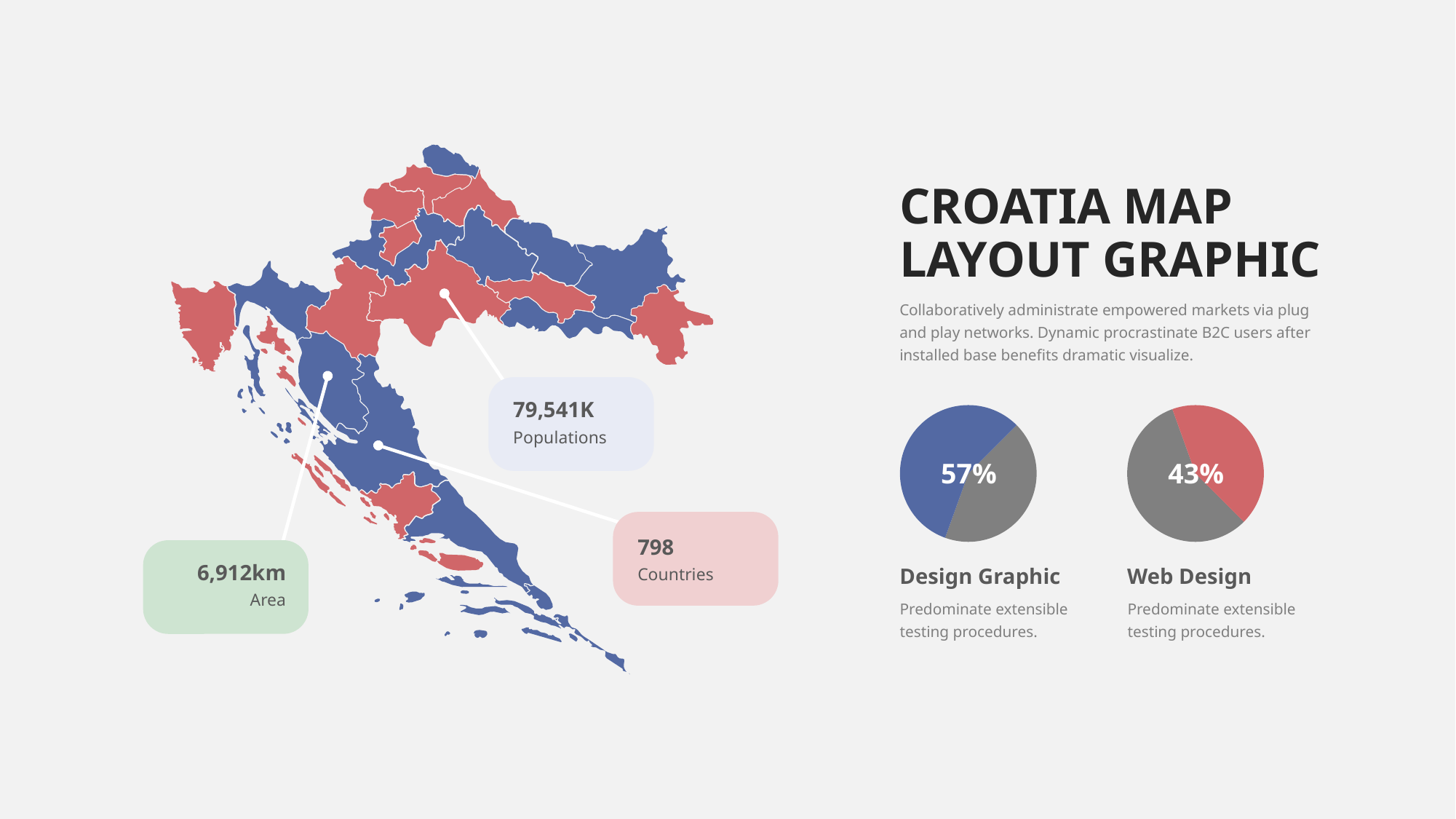
What kind of chart is used for Design Graphic and Web Design? Pie chart Is the value in the Web Design pie chart greater or less than 50%? less How many pie charts are on the slide? 2 Which pie chart shows the larger percentage, Design Graphic or Web Design? Design Graphic What percentage is shown in the Design Graphic pie chart? 57% What percentage is shown in the Web Design pie chart? 43% On the Croatia map graphic, what value is given for Area? 6,912km In the Web Design pie chart, what colour is the 43% slice? Red On the Croatia map graphic, what value is given for Populations? 79,541K Is the value in the Design Graphic pie chart greater or less than 50%? greater What is the difference in percentage points between the Design Graphic pie chart and the Web Design pie chart? 14 percentage points In the Design Graphic pie chart, what colour is the 57% slice? Blue